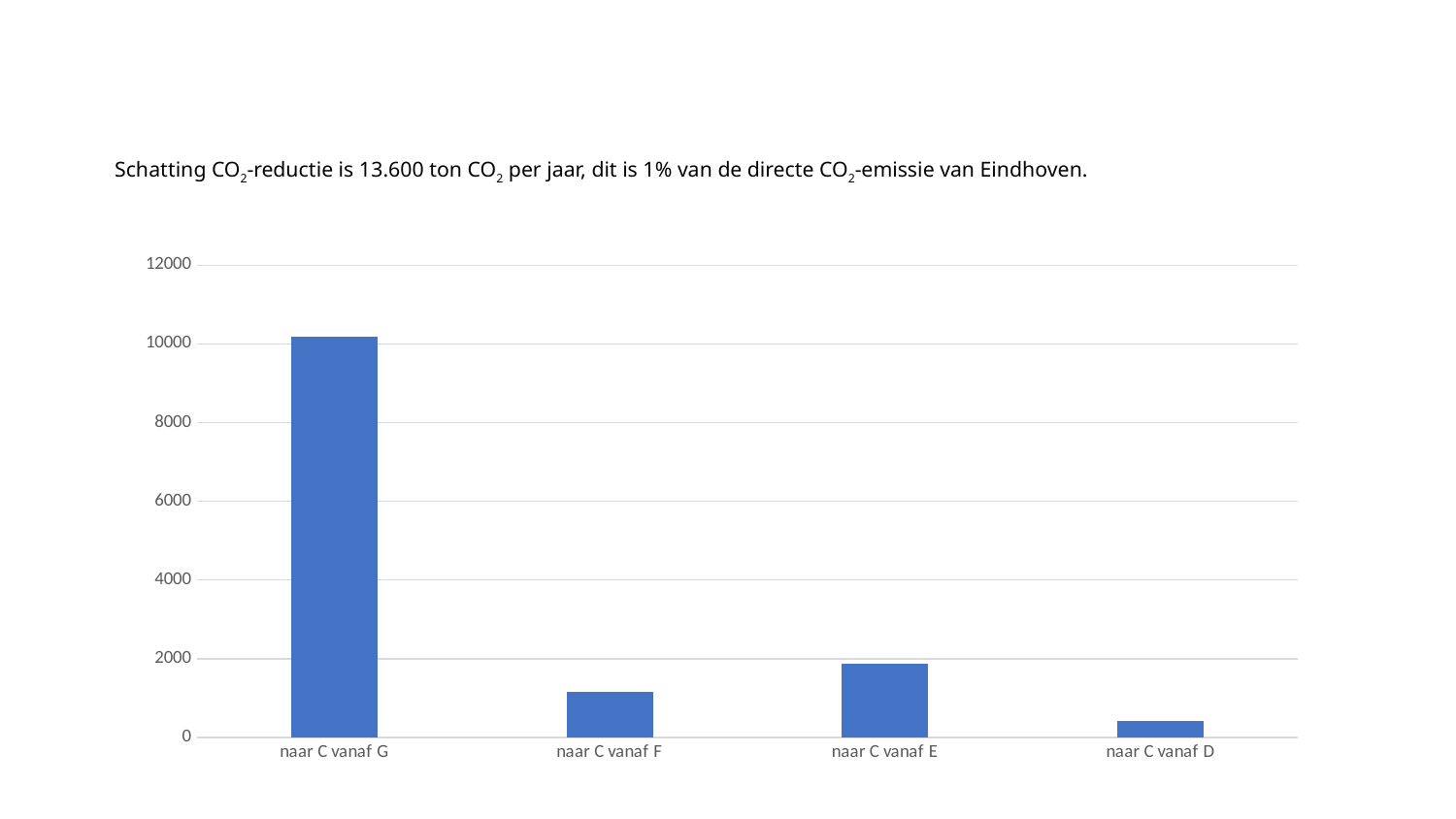
Which category has the highest value? naar C vanaf G Is the value for naar C vanaf D greater or less than 2000? less Which is larger, the value for naar C vanaf D or the value for naar C vanaf F? naar C vanaf F What kind of chart is shown on the slide? bar chart How many categories are shown on the x axis? 4 Which is larger, the value for naar C vanaf G or the value for naar C vanaf E? naar C vanaf G Is the value for naar C vanaf E greater or less than 4000? less Is the value for naar C vanaf F greater or less than 2000? less Which is larger, the value for naar C vanaf F or the value for naar C vanaf E? naar C vanaf E What colour are the bars in the chart? blue Which category has the lowest value? naar C vanaf D